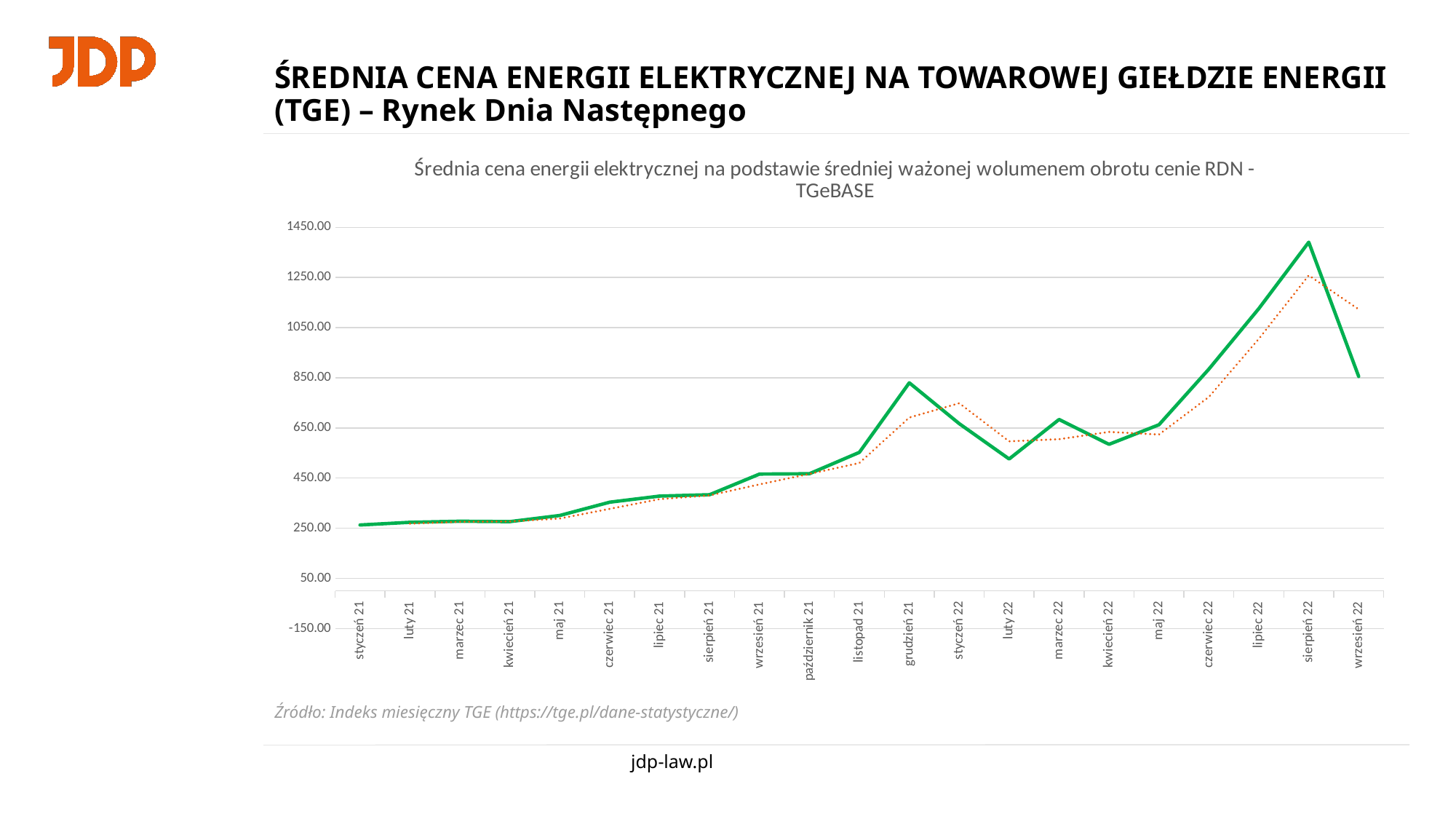
What is the highest value shown on the y axis? 1450.00 What kind of chart is shown on the slide? line chart Is the value of the solid green line for grudzień 21 greater or less than 650? greater Is the value of the solid green line for sierpień 22 greater or less than 1250? greater Is the value of the solid green line for luty 22 greater or less than 650? less In which month does the solid green line reach its highest value? sierpień 22 Does the solid green line generally rise or fall from styczeń 21 to sierpień 22? rise On the solid green line, which is higher: luty 22 or marzec 22? marzec 22 On the solid green line, which is higher: grudzień 21 or styczeń 22? grudzień 21 What is the title of the chart? Średnia cena energii elektrycznej na podstawie średniej ważonej wolumenem obrotu cenie RDN - TGeBASE How many months are plotted along the x axis? 21